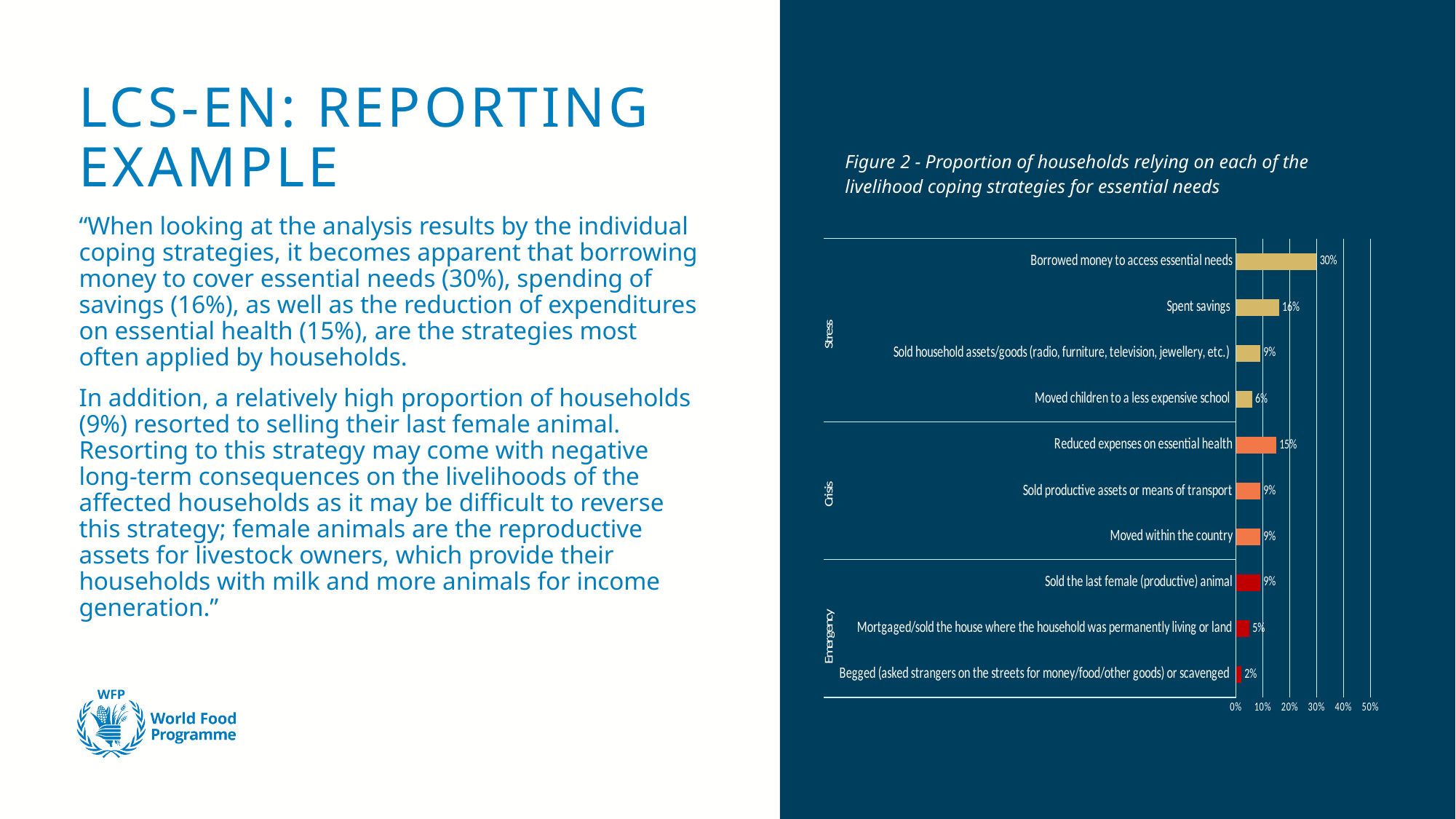
What is the difference in percentage points between households that borrowed money to access essential needs and those that spent savings? 14 Which coping strategy has the lowest proportion of households? Begged (asked strangers on the streets for money/food/other goods) or scavenged How many coping strategies are shown in the chart? 10 What proportion of households spent savings? 16% What proportion of households moved children to a less expensive school? 6% What proportion of households mortgaged/sold the house where the household was permanently living or land? 5% Which is larger: the proportion of households that sold the last female (productive) animal or the proportion that begged or scavenged? Sold the last female (productive) animal What proportion of households borrowed money to access essential needs? 30% What proportion of households reduced expenses on essential health? 15% What are the three groups into which the coping strategies are categorised on the chart's vertical axis? Stress, Crisis, Emergency What type of chart is shown on the slide? Bar chart Which coping strategy has the highest proportion of households? Borrowed money to access essential needs